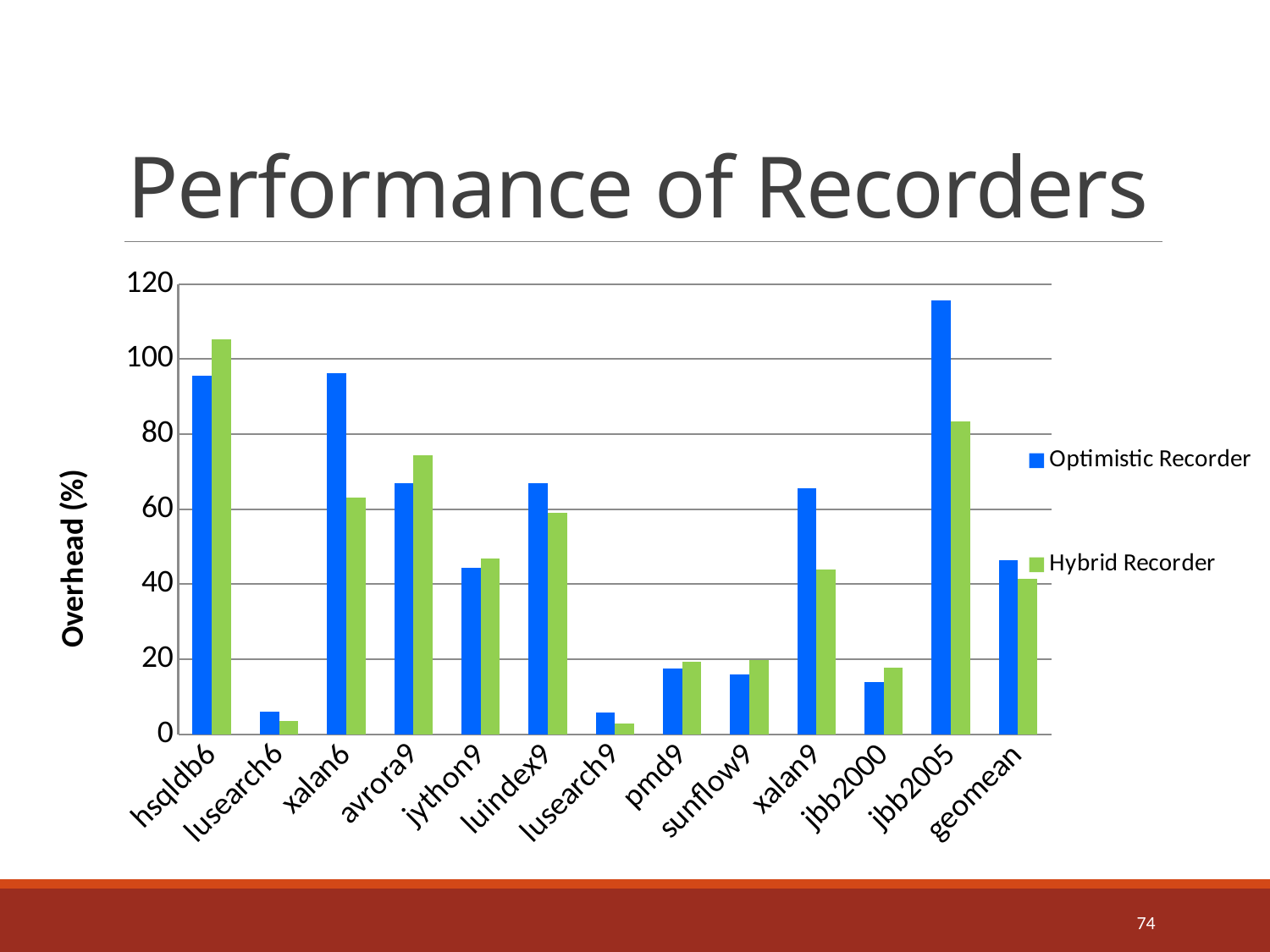
Which category has the highest Optimistic Recorder overhead? jbb2005 What is the label of the y axis? Overhead (%) Is the Optimistic Recorder overhead for jbb2005 greater or less than 100? greater Which category has the lowest Hybrid Recorder overhead? lusearch9 How many benchmark categories are shown on the x axis? 13 Which category has the highest Hybrid Recorder overhead? hsqldb6 What kind of chart is shown on the slide? bar chart How many series does the legend list? 2 For jbb2005, which series has the larger overhead, Optimistic Recorder or Hybrid Recorder? Optimistic Recorder Is the Hybrid Recorder overhead for xalan6 greater or less than 80? less For hsqldb6, which series has the larger overhead, Optimistic Recorder or Hybrid Recorder? Hybrid Recorder Is the Optimistic Recorder overhead for xalan6 greater or less than 80? greater